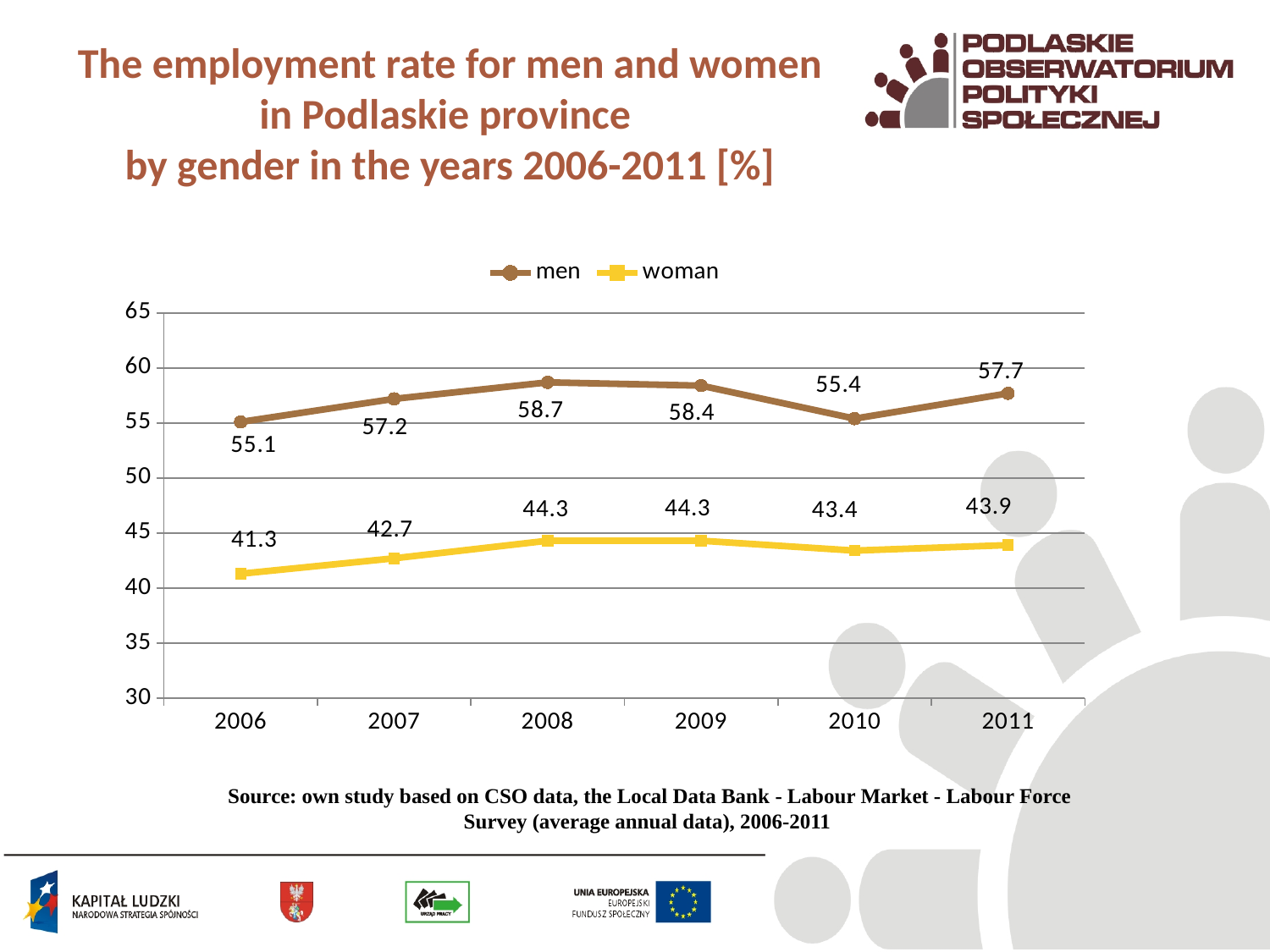
What was the employment rate for women in 2010? 43.4 What kind of chart is shown on the slide? line chart What was the employment rate for men in 2008? 58.7 Did the employment rate for women rise or fall from 2006 to 2008? rise In which year was the employment rate for men the highest? 2008 What is the difference between the employment rate for men and for women in 2011? 13.8 Is the employment rate for men in 2010 greater or less than 50? greater In which year was the employment rate for women the lowest? 2006 How many series does the legend list? 2 What colour is the line for women? yellow How many years are shown on the x axis? 6 Which was higher in 2009: the employment rate for men or for women? men